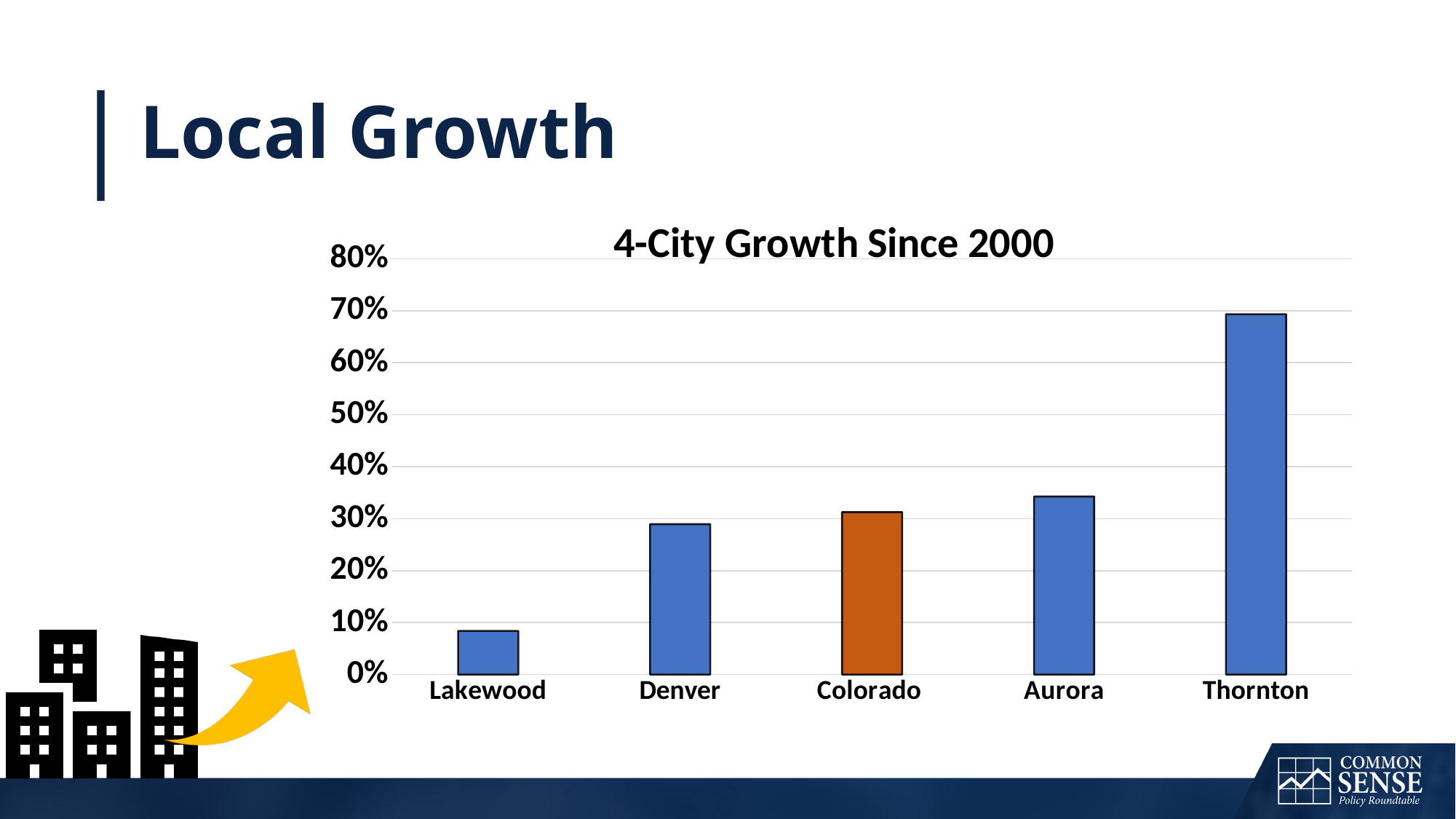
Which category's bar is shown in a different colour (orange) from the others? Colorado How many categories are shown on the x axis of the chart? 5 Which category has the highest growth since 2000? Thornton Is the value for Denver greater or less than 20%? greater What kind of chart is shown on the slide? bar chart Which category has the lowest growth since 2000? Lakewood Which has the larger value, Thornton or Aurora? Thornton Do the bar values generally rise or fall from left to right across the x axis? rise Is the value for Lakewood greater or less than 10%? less Is the value for Thornton greater or less than 60%? greater Which has the larger value, Lakewood or Denver? Denver What is the title of the chart? 4-City Growth Since 2000